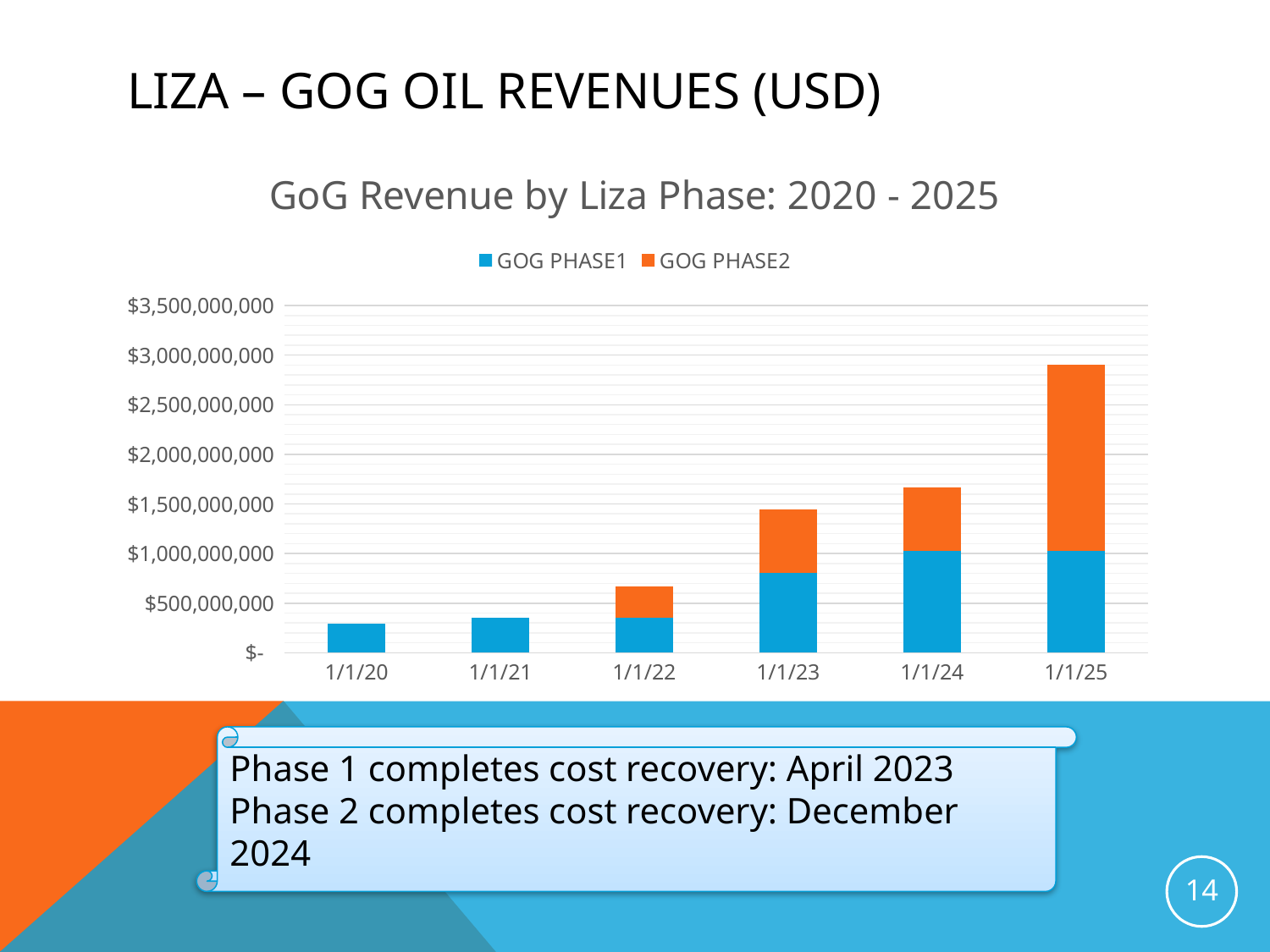
Is the total revenue for 1/1/20 greater or less than $500,000,000? less Do total GoG revenues rise or fall from 1/1/20 to 1/1/25? rise Which date has the lowest total GoG revenue? 1/1/20 Which has the larger total revenue, 1/1/23 or 1/1/24? 1/1/24 Is the total revenue for 1/1/23 greater or less than $1,000,000,000? greater How many dates are shown along the x axis of the chart? 6 Is the total revenue for 1/1/25 greater or less than $2,500,000,000? greater What is the title of the chart? GoG Revenue by Liza Phase: 2020 - 2025 How many series does the chart legend list? 2 What kind of chart is shown on the slide? Stacked bar chart Which date has the highest total GoG revenue? 1/1/25